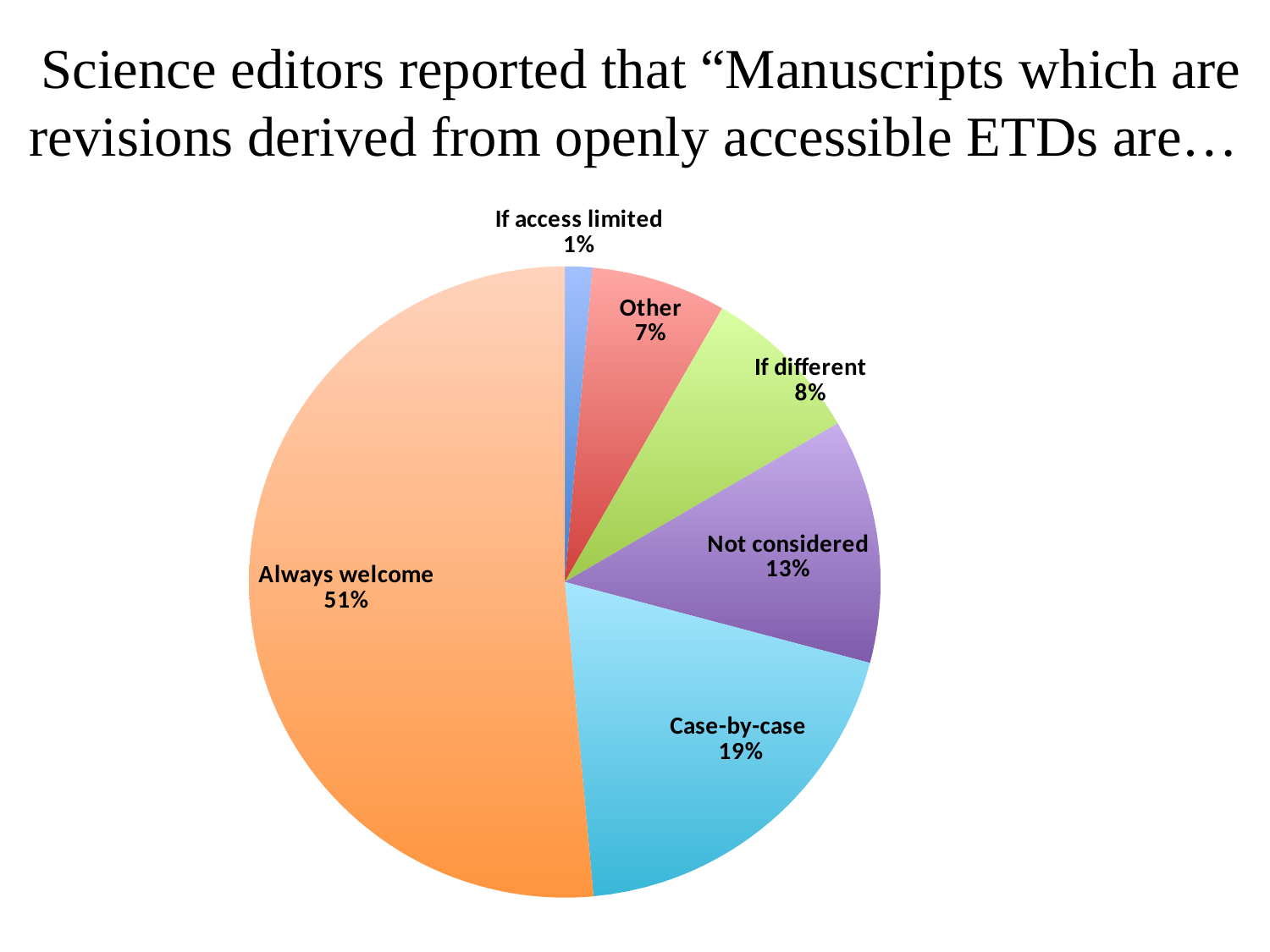
How many slices does the pie chart have? 6 Which category has the largest slice of the pie? Always welcome What kind of chart is shown on the slide? pie chart What share of the pie is labelled "Always welcome"? 51% Which category has the smallest slice of the pie? If access limited What percentage is shown for "Case-by-case"? 19% Which is larger, the share for "Other" or the share for "If different"? If different What percentage is shown for "If different"? 8% What percentage is shown for "Not considered"? 13% What is the difference in percentage points between "Case-by-case" and "Not considered"? 6 What colour is the "Case-by-case" slice? blue What percentage is shown for "If access limited"? 1%